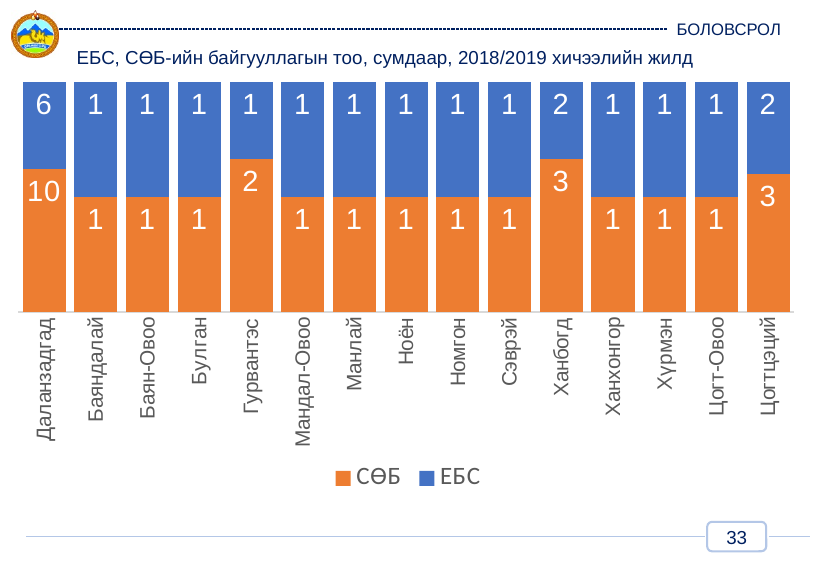
What is the СӨБ value for Ханбогд? 3 Which category has the highest СӨБ value? Даланзадгад What is the СӨБ value for Даланзадгад? 10 What is the total of the stacked bar for Ханбогд? 4 What is the ЕБС value for Цогтцэций? 2 What is the difference between the СӨБ and ЕБС values for Даланзадгад? 4 How many series does the legend list? 2 What is the СӨБ value for Гурвантэс? 2 How many categories are shown on the x axis? 15 What is the ЕБС value for Даланзадгад? 6 What is the total of the stacked bar for Даланзадгад? 16 Which is larger for Цогтцэций, the СӨБ value or the ЕБС value? СӨБ